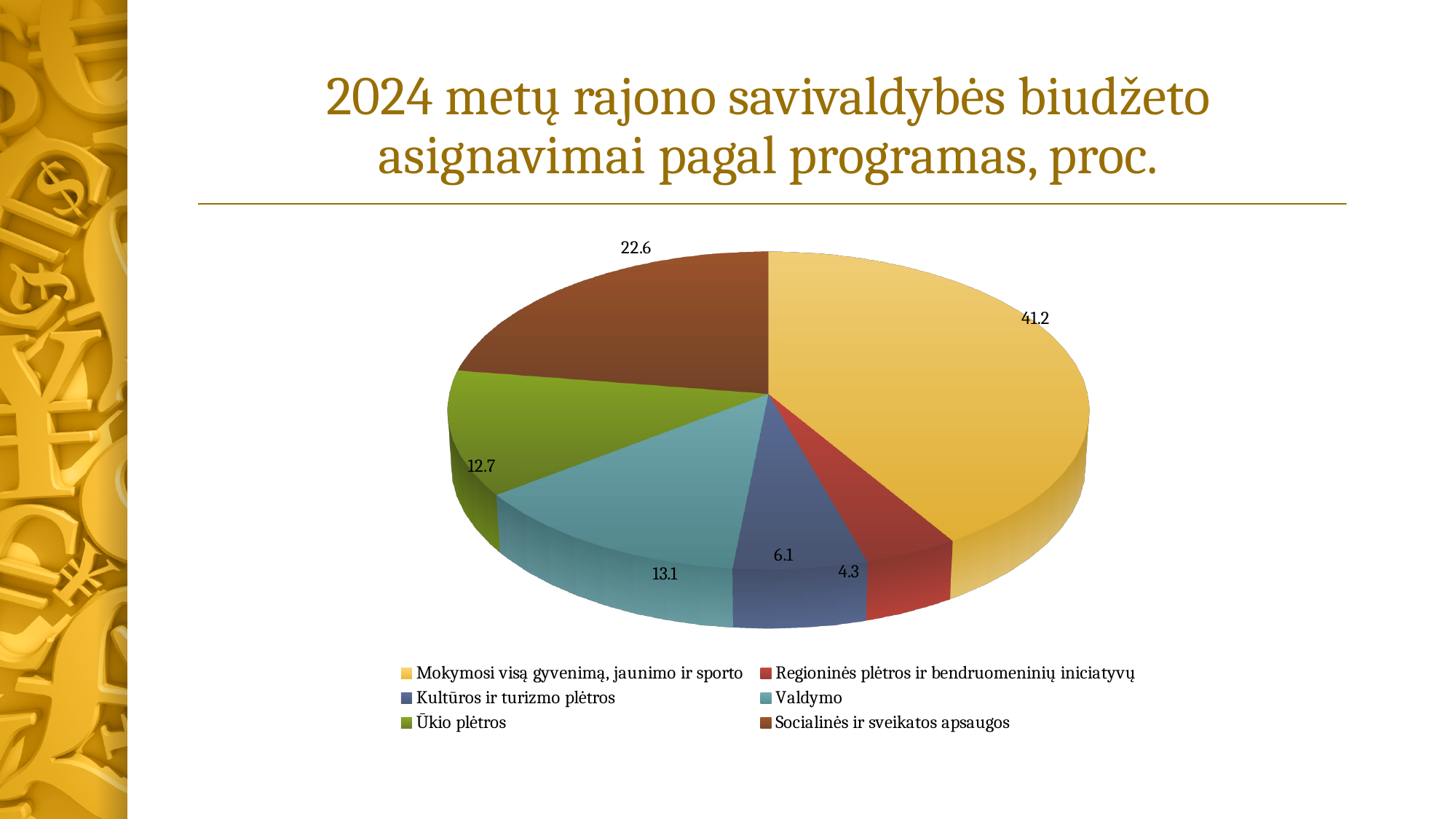
Which program has the largest share of the pie? Mokymosi visą gyvenimą, jaunimo ir sporto What type of chart is shown on the slide? Pie chart Which is larger, the value for Valdymo or the value for Ūkio plėtros? Valdymo What colour is the slice for Kultūros ir turizmo plėtros? Blue What is the value for Socialinės ir sveikatos apsaugos? 22.6 What is the difference between the values for Socialinės ir sveikatos apsaugos and Ūkio plėtros? 9.9 Which program has the smallest share of the pie? Regioninės plėtros ir bendruomeninių iniciatyvų What is the value for Mokymosi visą gyvenimą, jaunimo ir sporto? 41.2 What is the title of the chart on the slide? 2024 metų rajono savivaldybės biudžeto asignavimai pagal programas, proc. What is the value for Regioninės plėtros ir bendruomeninių iniciatyvų? 4.3 How many slices does the pie chart have? 6 What is the value for Valdymo? 13.1